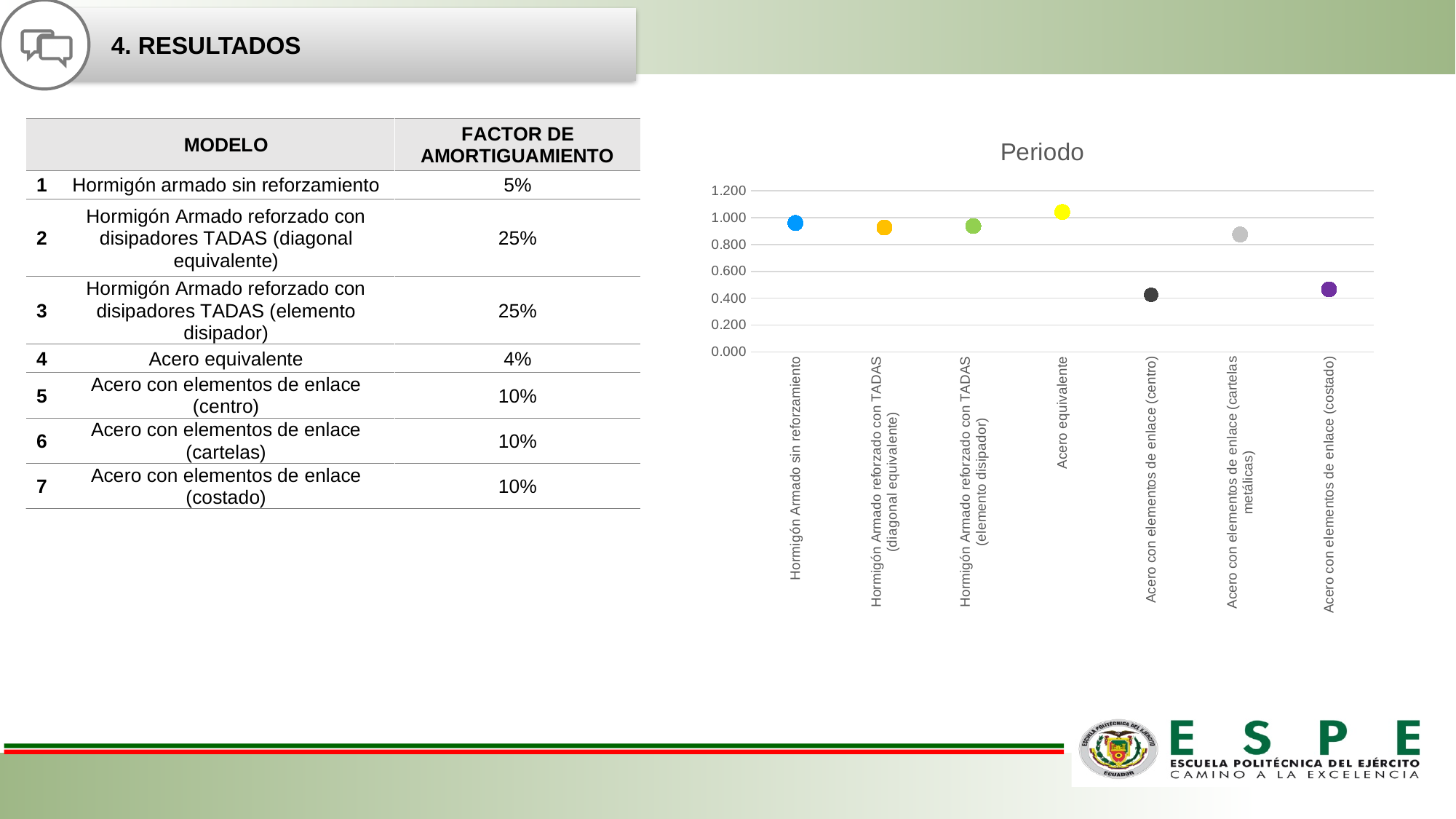
Is the value for Acero con elementos de enlace (centro) greater or less than 0.600? less Which category has the highest value in the Periodo chart? Acero equivalente Which is larger: the value for Hormigón Armado sin reforzamiento or the value for Acero con elementos de enlace (cartelas metálicas)? Hormigón Armado sin reforzamiento What colour is the marker for Acero equivalente in the Periodo chart? Yellow Is the value for Acero equivalente greater or less than 1.000? greater How many categories are plotted in the Periodo chart? 7 Is the value for Acero con elementos de enlace (cartelas metálicas) greater or less than 0.800? greater What is the title of the chart? Periodo Which is larger: the value for Acero equivalente or the value for Acero con elementos de enlace (centro)? Acero equivalente What kind of chart is shown on the slide? Scatter (dot) chart